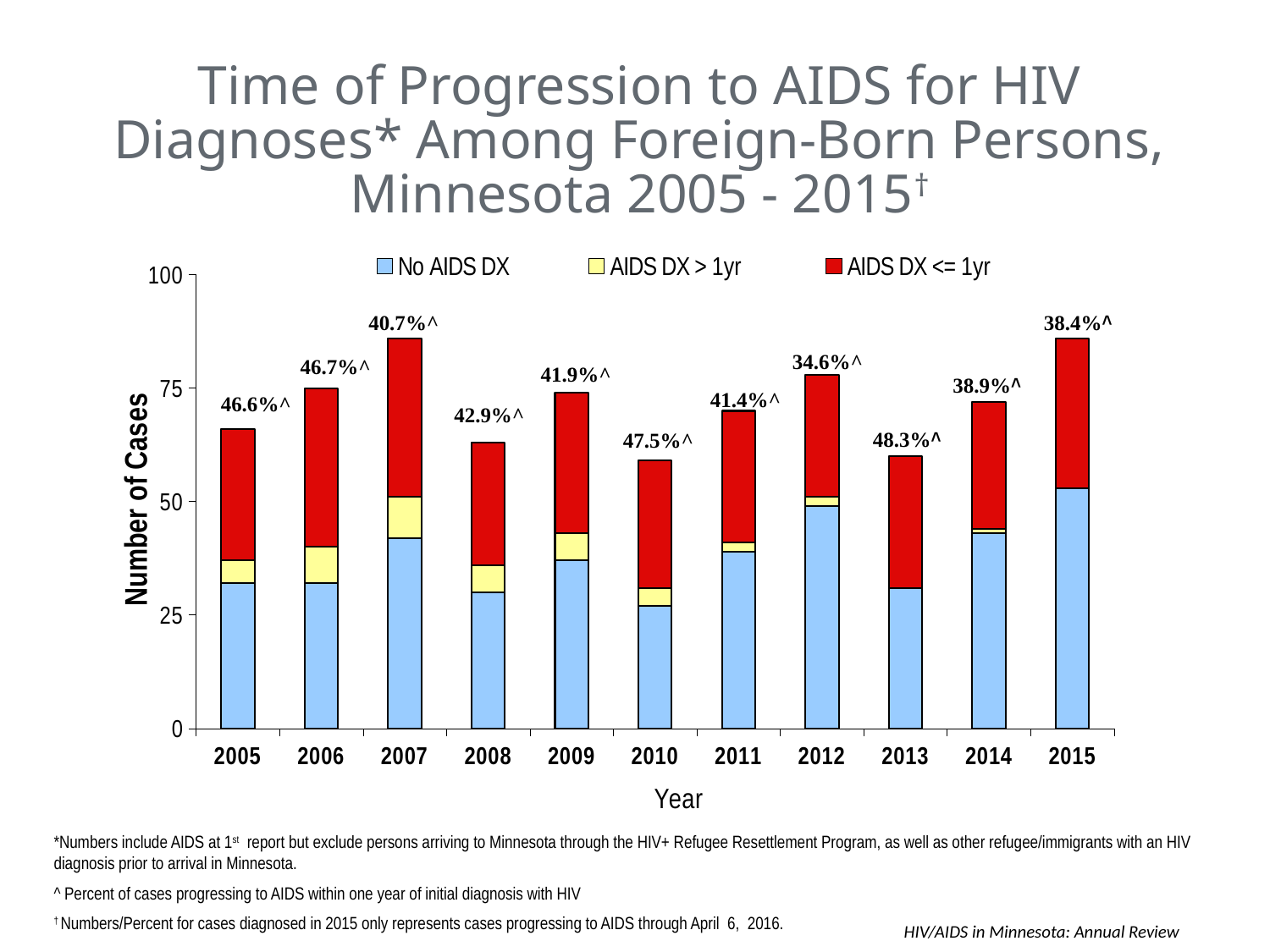
What is the difference between the percentage labels for 2013 and 2012? 13.7 percentage points How many years are shown on the x axis? 11 Which year has the highest percentage of cases progressing to AIDS within one year? 2013 What percentage label is shown above the 2013 bar? 48.3% Is the total number of cases for 2010 greater or less than 75? less Which year has a higher percentage label, 2010 or 2007? 2010 What kind of chart is shown on the slide? Stacked bar chart What percentage label is shown above the 2012 bar? 34.6% How many series does the legend list? 3 What percentage label is shown above the 2007 bar? 40.7% Which year has the lowest percentage of cases progressing to AIDS within one year? 2012 Is the total number of cases for 2007 greater or less than 75? greater